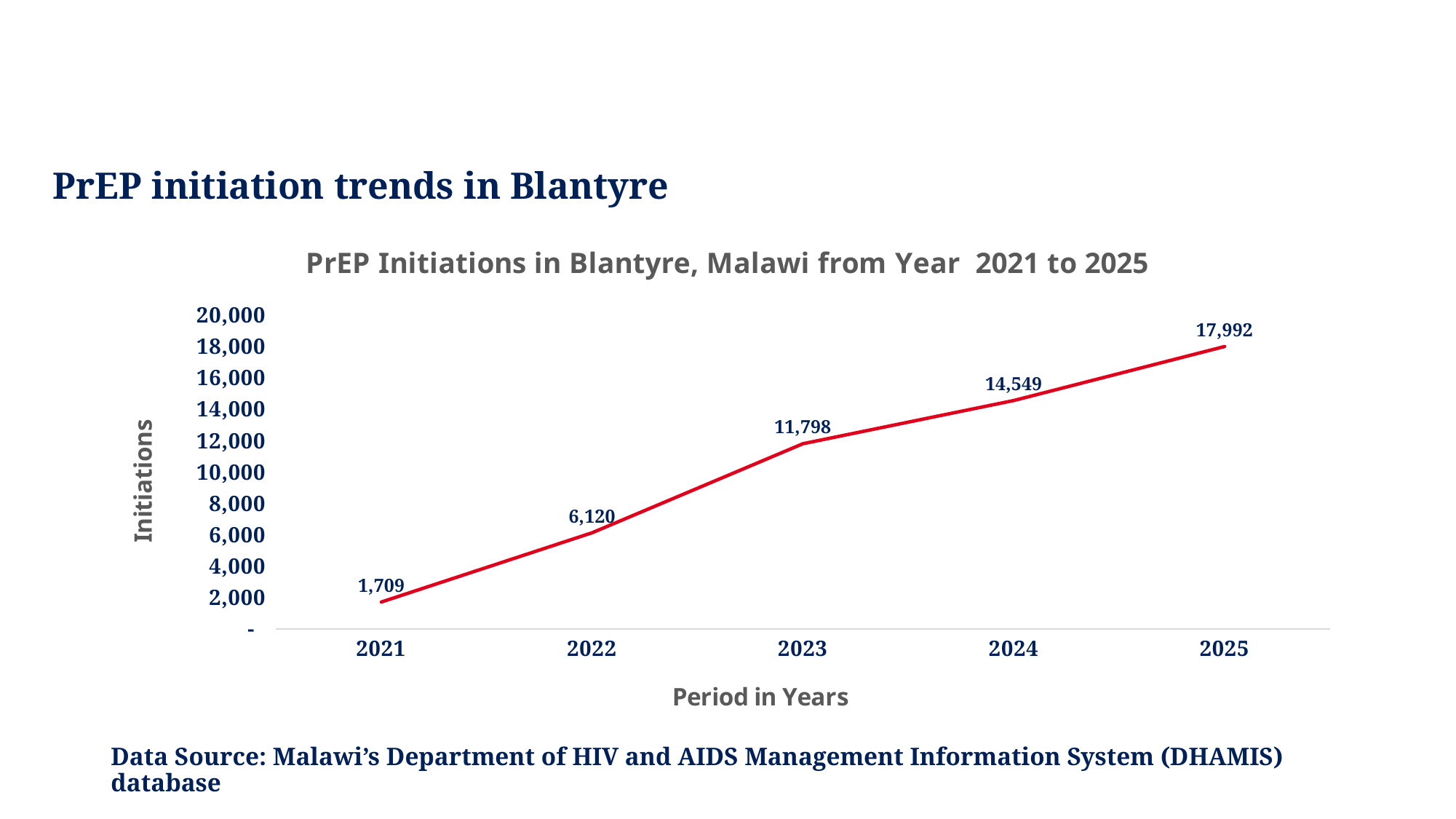
Do PrEP initiations rise or fall from 2021 to 2025? Rise Which year has the lowest number of PrEP initiations? 2021 Which year has the highest number of PrEP initiations? 2025 What kind of chart is shown on the slide? Line chart What is the number of PrEP initiations in 2025? 17,992 Which year had more PrEP initiations, 2022 or 2024? 2024 What is the difference in PrEP initiations between 2025 and 2024? 3,443 What is the difference in PrEP initiations between 2022 and 2021? 4,411 How many years are plotted on the chart? 5 Is the value for 2023 greater or less than 10,000? greater What is the number of PrEP initiations in 2021? 1,709 What is the number of PrEP initiations in 2023? 11,798